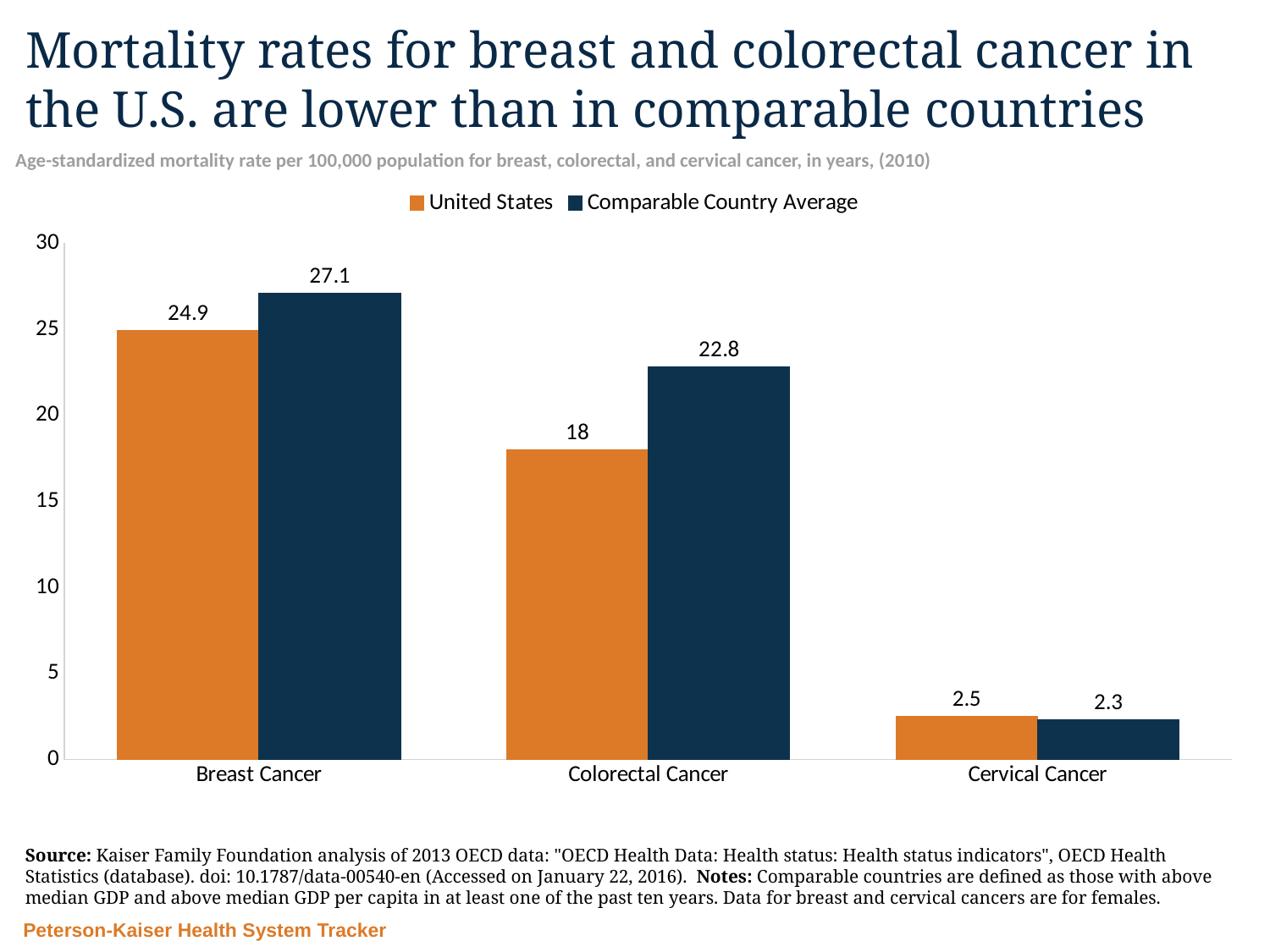
What is the difference between the Comparable Country Average and the United States mortality rate for colorectal cancer? 4.8 How many series does the legend list? 2 What is the difference between the Comparable Country Average and the United States mortality rate for breast cancer? 2.2 What kind of chart is shown on the slide? Bar chart For cervical cancer, which is larger: the United States rate or the Comparable Country Average rate? United States How many cancer types are shown on the x axis? 3 Which cancer type has the highest Comparable Country Average mortality rate? Breast Cancer What is the United States mortality rate for cervical cancer? 2.5 Which cancer type has the lowest United States mortality rate? Cervical Cancer What is the Comparable Country Average mortality rate for colorectal cancer? 22.8 Is the Comparable Country Average mortality rate for breast cancer greater or less than 25? greater What is the United States mortality rate for breast cancer? 24.9